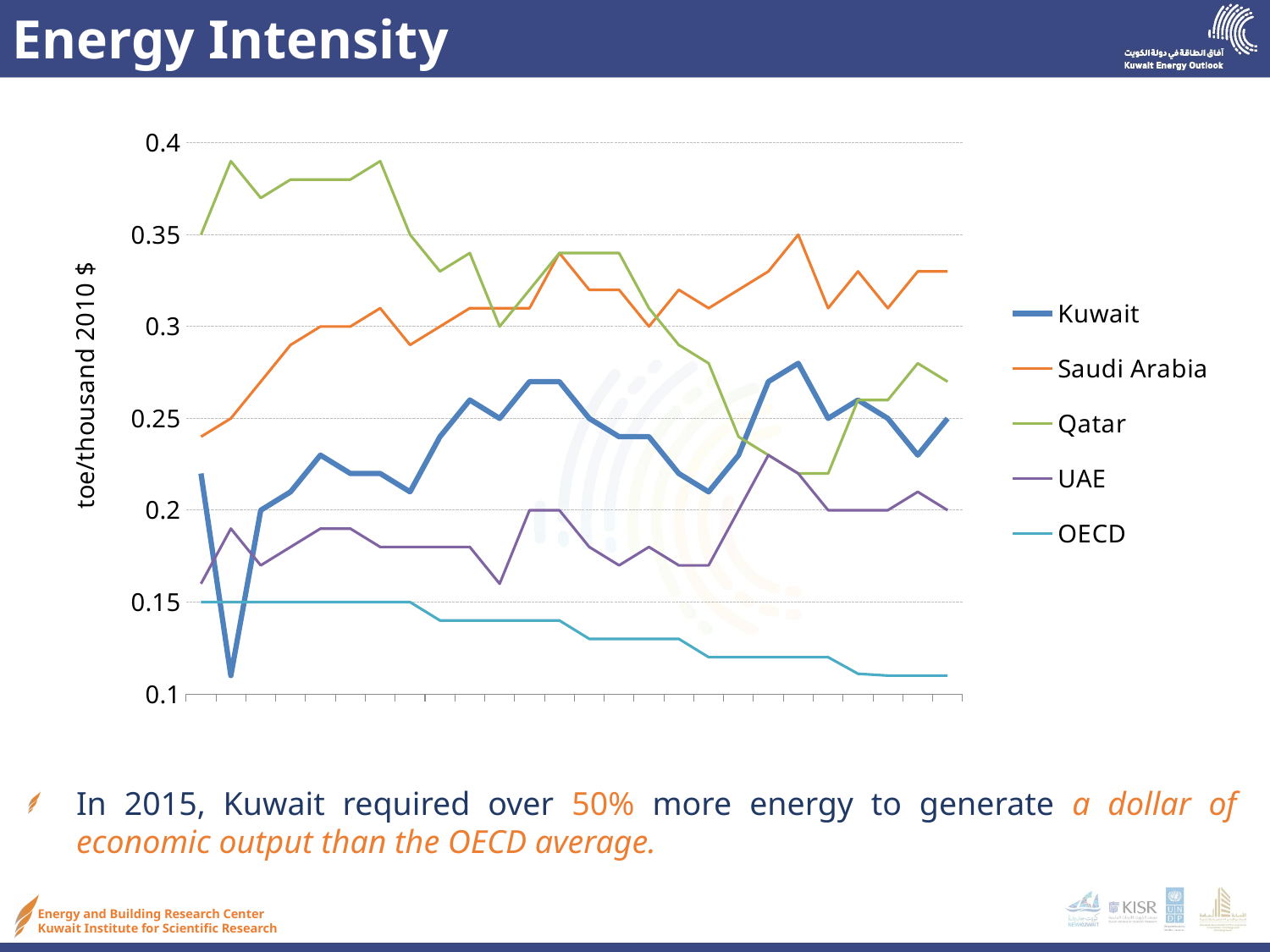
Does the OECD line rise or fall along the x axis? fall Which series reaches the highest peak anywhere on the chart? Qatar How many series does the legend list? 5 Which series has the lowest value at the right end of the chart? OECD Which series is drawn with the thick blue line? Kuwait Is the lowest point of the Kuwait line greater or less than 0.15? less Is the highest point of the UAE line greater or less than 0.25? less What is the label on the vertical axis of the chart? toe/thousand 2010 $ Is the OECD value at the right end of the chart greater or less than 0.15? less Which series has the highest value at the right end of the chart? Saudi Arabia Which series has the highest value at the left end of the chart? Qatar What kind of chart is shown on the slide? line chart